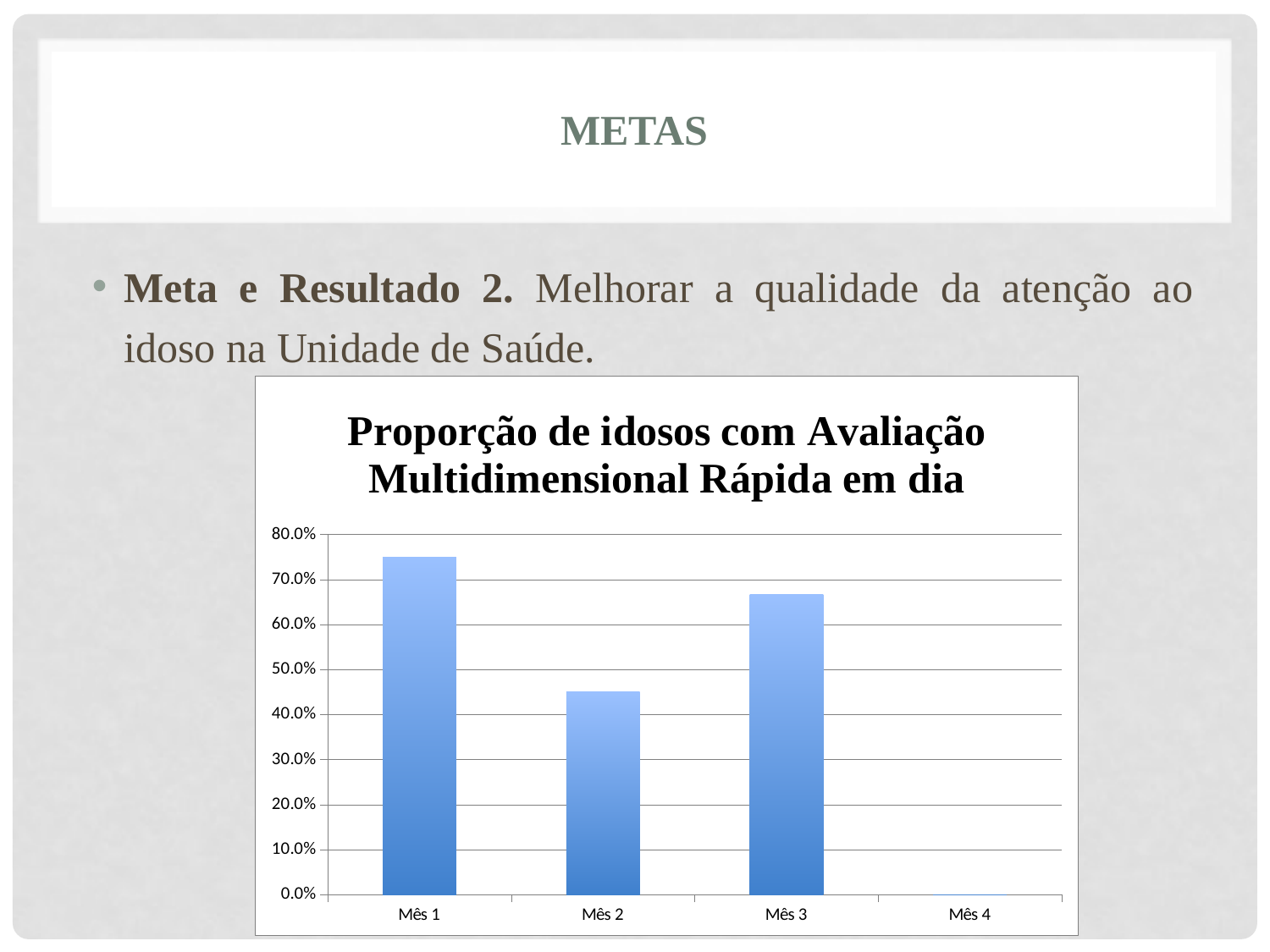
Is the value for Mês 2 greater or less than 50.0%? less Which is larger, the value for Mês 1 or the value for Mês 3? Mês 1 Is the value for Mês 1 greater or less than 70.0%? greater What is the title of the chart? Proporção de idosos com Avaliação Multidimensional Rápida em dia Which month has the highest value in the chart? Mês 1 Which is larger, the value for Mês 2 or the value for Mês 3? Mês 3 Is the value for Mês 2 greater or less than 40.0%? greater Among Mês 1, Mês 2 and Mês 3, which month has the lowest value? Mês 2 How many categories are shown on the x axis of the chart? 4 Does the value rise or fall from Mês 1 to Mês 2? fall What kind of chart is shown on the slide? bar chart